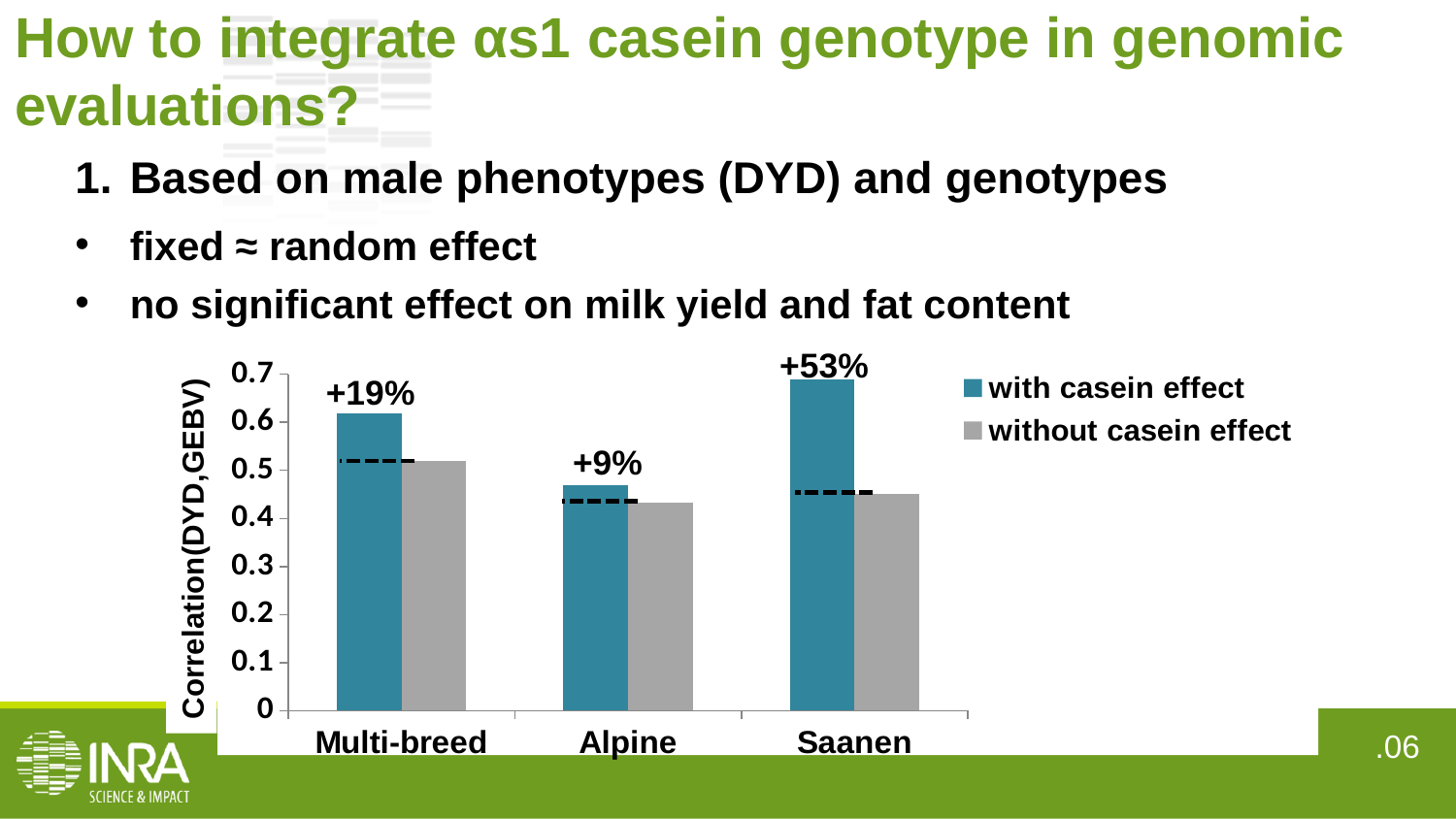
How many series does the chart legend list? 2 Is the 'with casein effect' value for Alpine greater or less than 0.5? less Which category has the highest value for the 'with casein effect' series? Saanen What kind of chart is shown on the slide? bar chart What is the label of the y axis of the chart? Correlation(DYD,GEBV) Which is larger: the 'with casein effect' value for Multi-breed or the 'with casein effect' value for Alpine? Multi-breed What percentage gain is printed above the Alpine bars? +9% Is the 'with casein effect' value for Multi-breed greater or less than 0.6? greater Which category has the lowest value for the 'without casein effect' series? Alpine Is the 'without casein effect' value for Saanen greater or less than 0.5? less What percentage gain is printed above the Saanen bars? +53% How many categories are shown on the x axis of the chart? 3